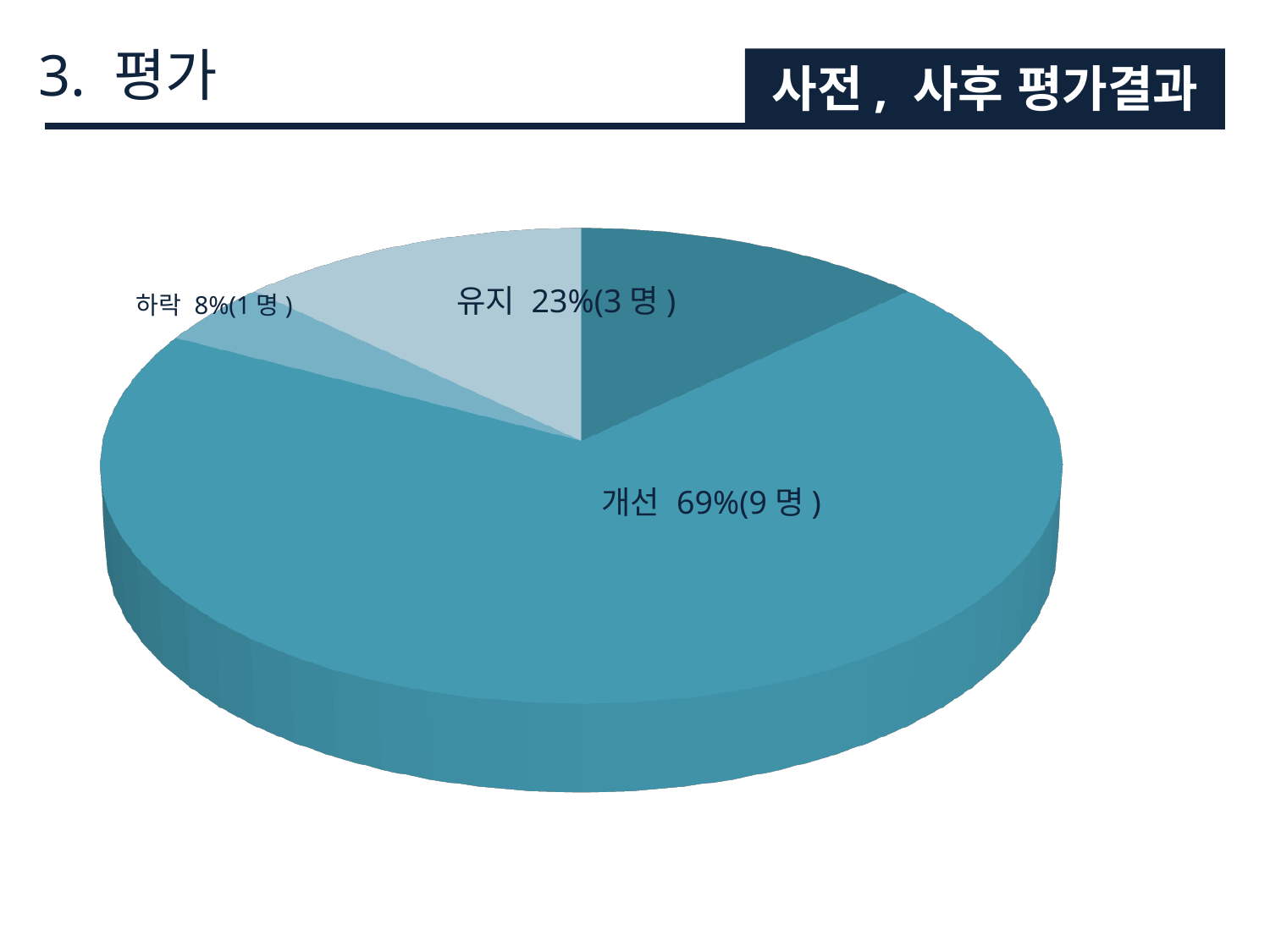
What kind of chart is shown on the slide? Pie chart What is the title shown in the header box at the top right of the slide? 사전, 사후 평가결과 Which category has the largest share of the pie? 개선 What is the difference in percentage points between the 개선 share and the 유지 share? 46 percentage points How many more people are in the 개선 category than in the 하락 category? 8명 What percentage share does the 하락 slice have? 8% Which is larger, the share for 유지 or the share for 하락? 유지 How many slices does the pie chart have? 4 What is the total number of people across all three categories? 13명 Which category has the smallest share of the pie? 하락 What percentage share does the 개선 slice have? 69% How many people are in the 유지 category? 3명